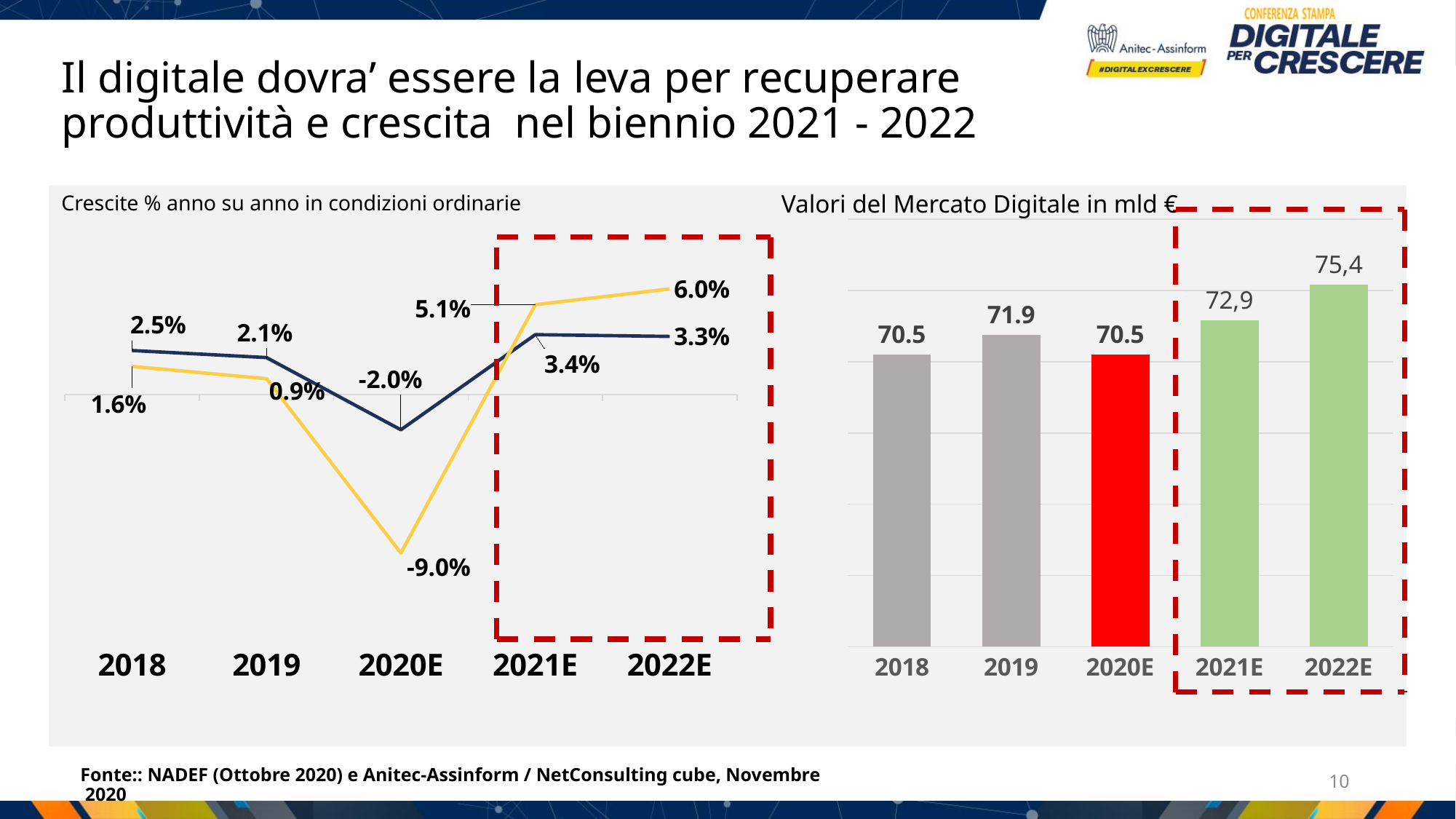
In the chart 'Valori del Mercato Digitale in mld €', what is the difference between the 2022E and 2021E values? 2,5 In the chart 'Crescite % anno su anno in condizioni ordinarie', what is the value of the dark blue line for 2021E? 3.4% In the chart 'Valori del Mercato Digitale in mld €', which year has the highest value? 2022E In the chart 'Valori del Mercato Digitale in mld €', which bar is coloured red? 2020E What kind of chart is 'Crescite % anno su anno in condizioni ordinarie'? Line chart In the chart 'Crescite % anno su anno in condizioni ordinarie', what is the difference between the yellow line's 2022E value and its 2021E value? 0.9% What kind of chart is 'Valori del Mercato Digitale in mld €'? Bar chart In the chart 'Valori del Mercato Digitale in mld €', what is the value for 2022E? 75,4 In the chart 'Valori del Mercato Digitale in mld €', how many bars are shown? 5 In the chart 'Valori del Mercato Digitale in mld €', what is the value for 2019? 71.9 In the chart 'Crescite % anno su anno in condizioni ordinarie', what is the value of the yellow line for 2020E? -9.0% In the chart 'Crescite % anno su anno in condizioni ordinarie', which line has the higher value for 2022E, the yellow line or the dark blue line? Yellow line